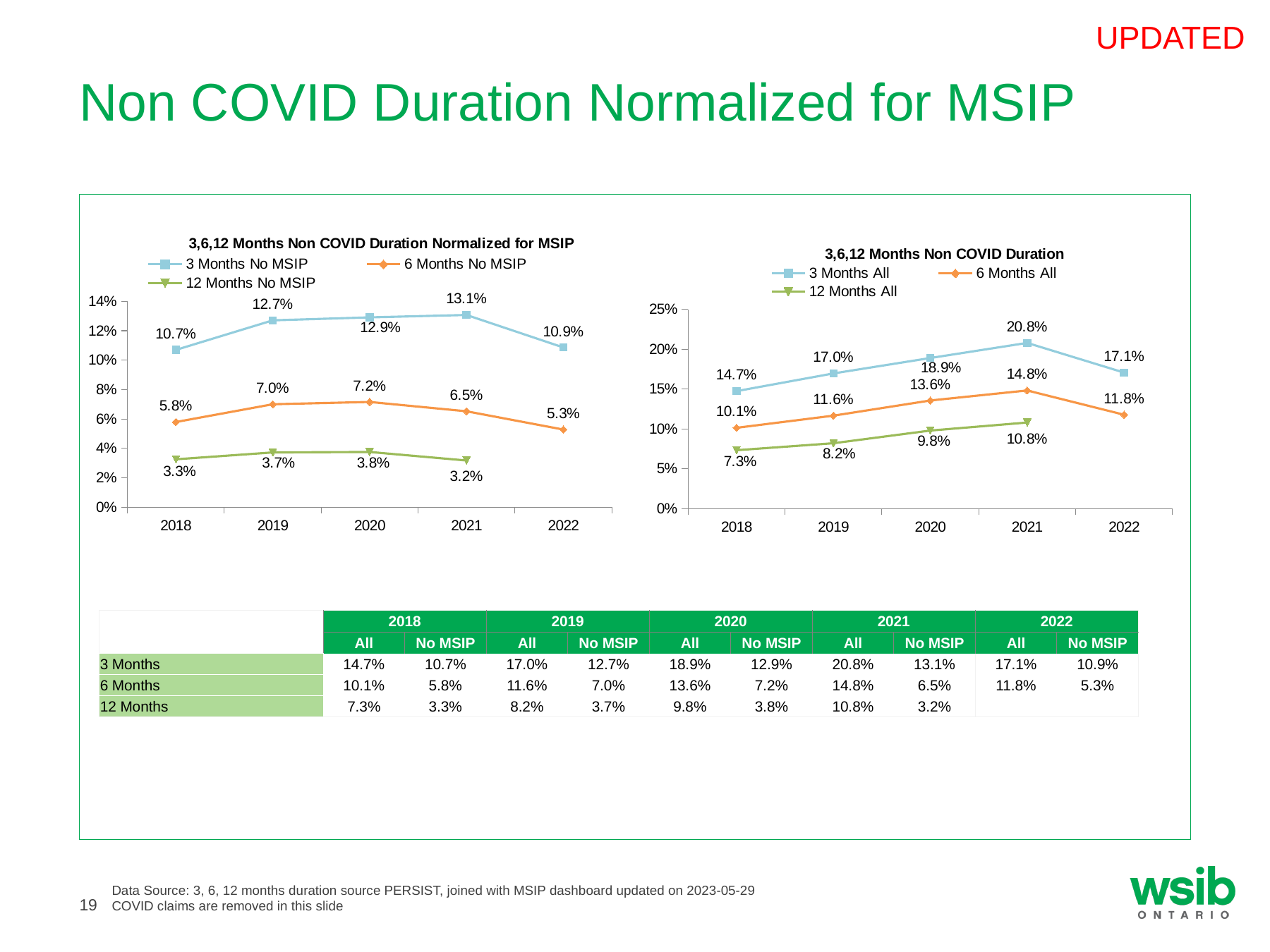
How many years are shown on the x axis of the chart titled '3,6,12 Months Non COVID Duration'? 5 What kind of chart is the chart titled '3,6,12 Months Non COVID Duration'? Line chart In the chart titled '3,6,12 Months Non COVID Duration', what is the difference between the 3 Months All value in 2021 and in 2022? 3.7% In the chart titled '3,6,12 Months Non COVID Duration Normalized for MSIP', which is larger: the 12 Months No MSIP value in 2019 or in 2021? 2019 How many series does the legend of the chart titled '3,6,12 Months Non COVID Duration Normalized for MSIP' list? 3 In the chart titled '3,6,12 Months Non COVID Duration Normalized for MSIP', in which year is the 6 Months No MSIP value highest? 2020 In the chart titled '3,6,12 Months Non COVID Duration', does the 12 Months All series rise or fall from 2018 to 2021? Rise In the chart titled '3,6,12 Months Non COVID Duration Normalized for MSIP', what is the value for 3 Months No MSIP in 2021? 13.1% In the chart titled '3,6,12 Months Non COVID Duration Normalized for MSIP', what is the difference between the 3 Months No MSIP and 6 Months No MSIP values in 2018? 4.9% In the chart titled '3,6,12 Months Non COVID Duration', in which year is the 3 Months All value lowest? 2018 In the chart titled '3,6,12 Months Non COVID Duration', is the 12 Months All value in 2021 greater or less than 10%? greater In the chart titled '3,6,12 Months Non COVID Duration', what is the value for 6 Months All in 2020? 13.6%